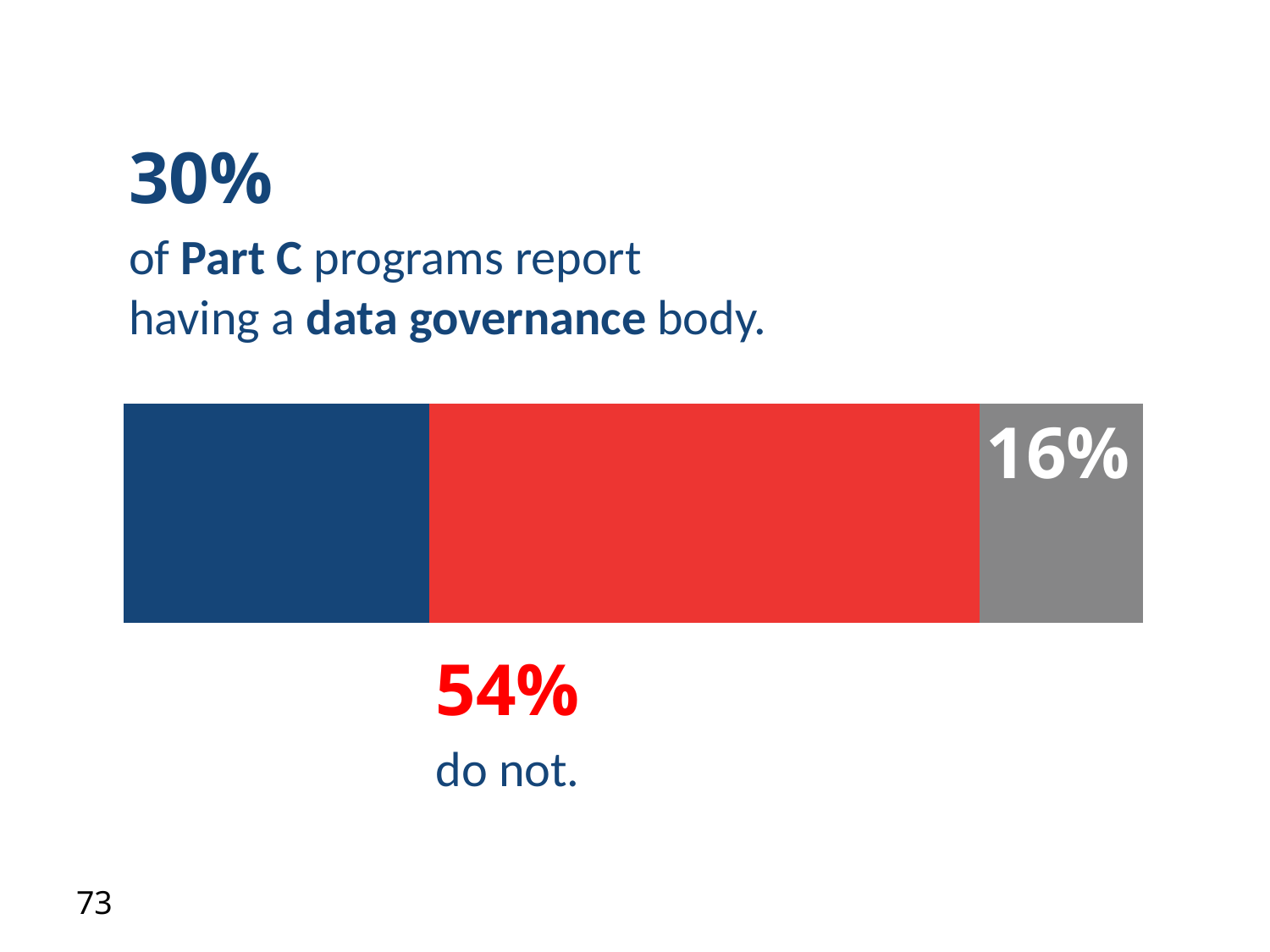
What value is printed on the gray segment of the bar? 16% How many segments make up the bar? 3 What kind of chart is shown on the slide? Stacked bar chart What colour is the segment representing Part C programs that have a data governance body? Blue What is the total of the three segments in the bar? 100% What colour is the segment representing the 54% that do not have a data governance body? Red What is the difference between the share of Part C programs that do not have a data governance body and the share that do? 24% Which segment of the bar is the smallest? 16% (gray segment) Which is larger: the share of Part C programs with a data governance body or the share without one? The share without one (54%) Which segment of the bar is the largest? 54% (do not) What percentage of Part C programs report not having a data governance body? 54% What percentage of Part C programs report having a data governance body? 30%